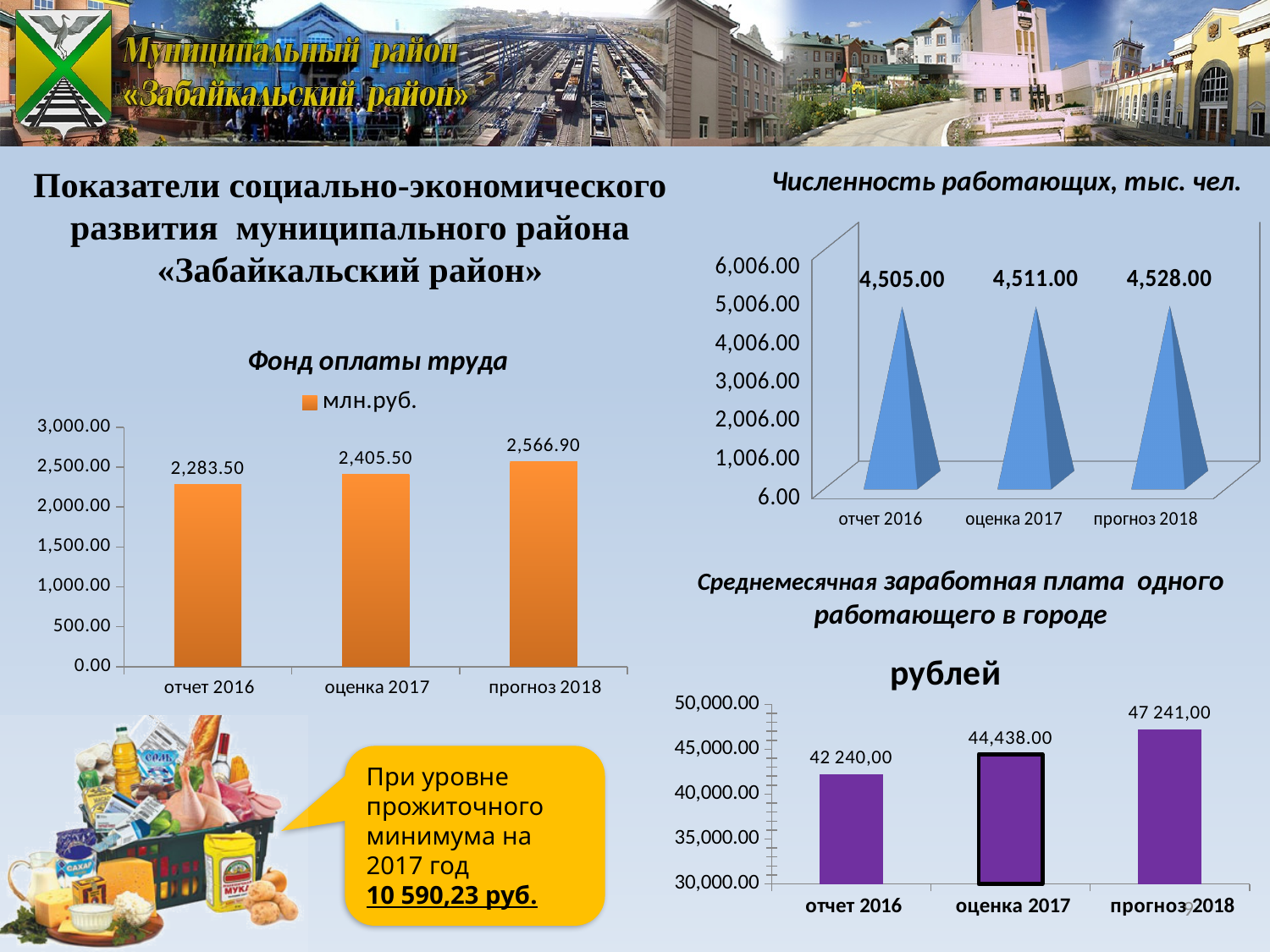
In the 'Фонд оплаты труда' chart, which category has the highest value? прогноз 2018 In the 'Численность работающих, тыс. чел.' chart, what is the value for оценка 2017? 4,511.00 In the 'Фонд оплаты труда' chart, what is the value for прогноз 2018? 2,566.90 In the 'Фонд оплаты труда' chart, what series name does the legend show? млн.руб. In the 'Фонд оплаты труда' chart, do the values rise or fall from отчет 2016 to прогноз 2018? rise In the 'Среднемесячная заработная плата одного работающего в городе' chart, what is the value for оценка 2017? 44,438.00 In the 'Фонд оплаты труда' chart, what is the difference between прогноз 2018 and оценка 2017? 161.40 In the 'Фонд оплаты труда' chart, what is the value for отчет 2016? 2,283.50 In the 'Численность работающих, тыс. чел.' chart, how many categories are shown on the x axis? 3 In the 'Численность работающих, тыс. чел.' chart, what is the value for прогноз 2018? 4,528.00 In the 'Среднемесячная заработная плата одного работающего в городе' chart, what is the value for отчет 2016? 42 240,00 In the 'Среднемесячная заработная плата одного работающего в городе' chart, which category has the lowest value? отчет 2016